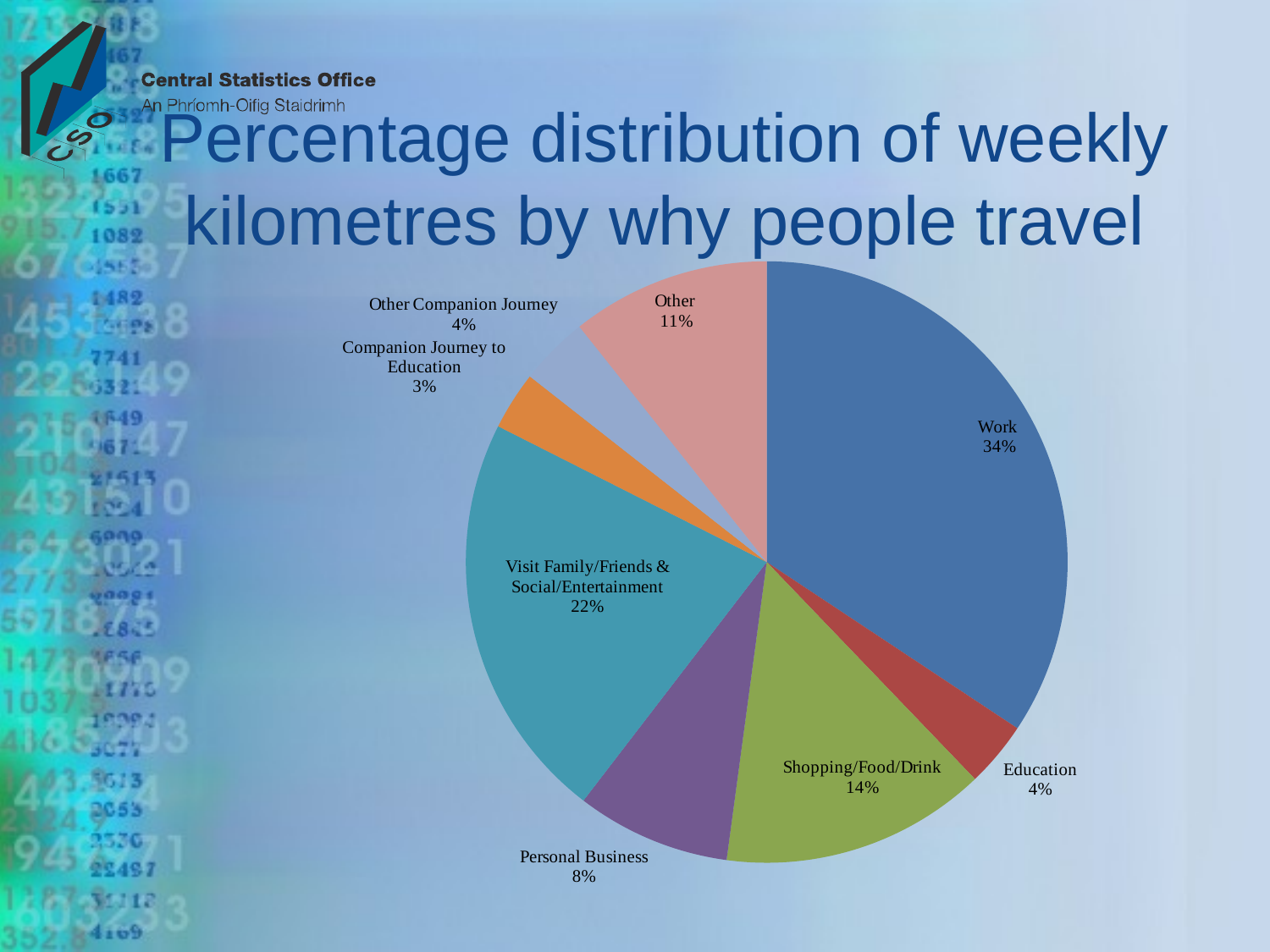
What is the title of the chart on the slide? Percentage distribution of weekly kilometres by why people travel Which category accounts for the smallest share of weekly kilometres? Companion Journey to Education Which is larger, the share for Other or the share for Personal Business? Other What percentage of weekly kilometres is for Visit Family/Friends & Social/Entertainment? 22% Which category accounts for the largest share of weekly kilometres? Work What percentage of weekly kilometres is for Shopping/Food/Drink? 14% How many categories are shown in the pie chart? 8 How many percentage points larger is the Work share than the Personal Business share? 26 What percentage of weekly kilometres is for Companion Journey to Education? 3% What percentage of weekly kilometres is for Work? 34% What kind of chart is shown on the slide? pie chart What is the share of the pie for Education? 4%